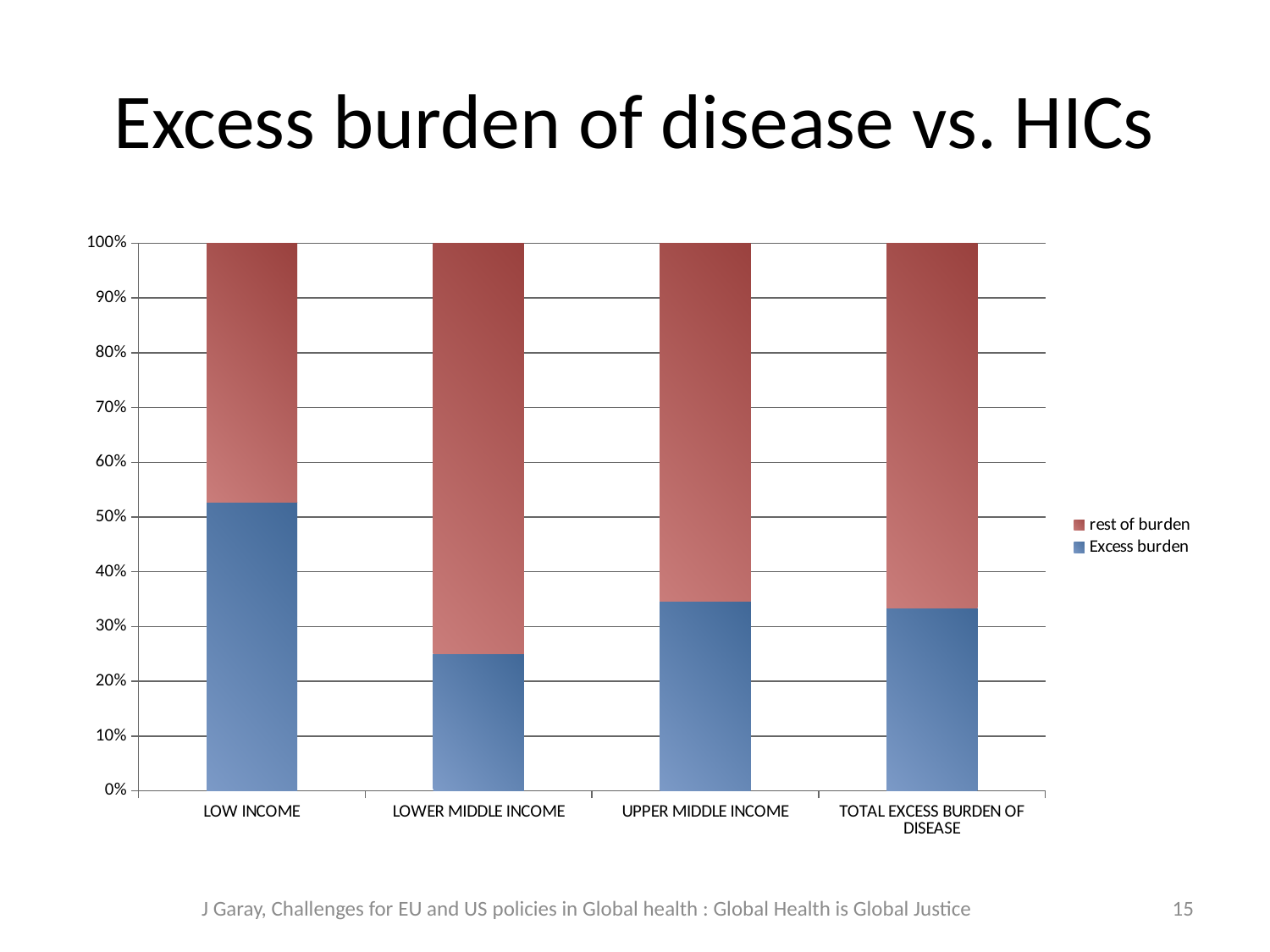
Which colour represents the 'rest of burden' series in the legend? red Which category has the lowest Excess burden share? LOWER MIDDLE INCOME Which category has the highest Excess burden share? LOW INCOME What is the title of the chart? Excess burden of disease vs. HICs What is the total height of the LOW INCOME stacked bar? 100% What kind of chart is shown on the slide? stacked bar chart Is the Excess burden value for UPPER MIDDLE INCOME greater or less than 30%? greater How many categories are shown on the x axis? 4 How many series does the legend list? 2 Is the Excess burden value for LOW INCOME greater or less than 50%? greater Which has a larger Excess burden share, LOW INCOME or LOWER MIDDLE INCOME? LOW INCOME Is the Excess burden value for LOWER MIDDLE INCOME greater or less than 30%? less